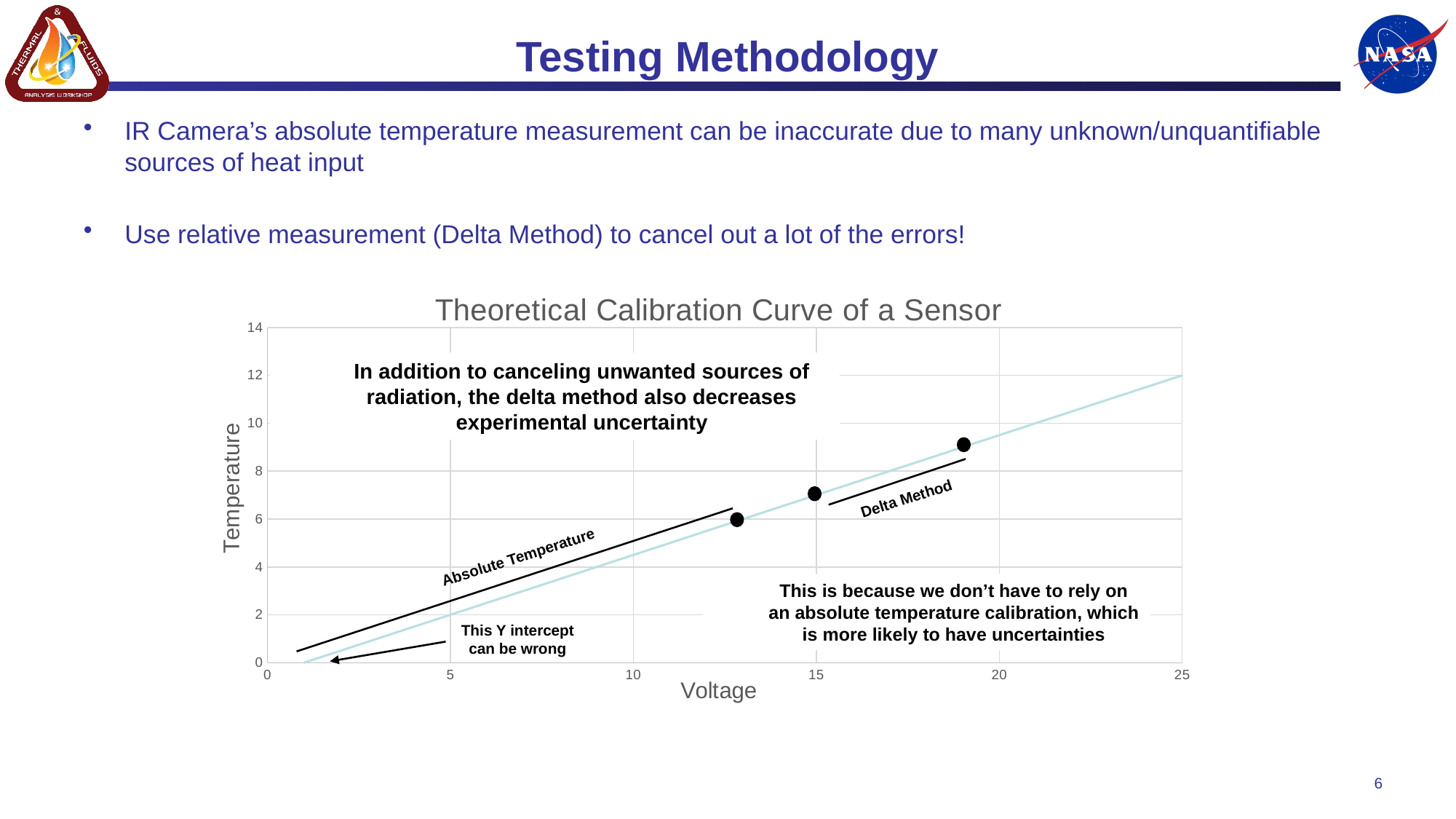
What kind of chart is shown on the slide? line chart Does the temperature rise or fall as voltage increases along the x axis? rise Is the temperature of the rightmost black data point greater or less than 8? greater What is the title of the chart? Theoretical Calibration Curve of a Sensor What is the highest value shown on the Temperature axis? 14 How many black data points are plotted on the chart? 3 Is the temperature of the rightmost black data point greater or less than 10? less Is the temperature of the leftmost black data point greater or less than 8? less What is the label of the x axis of the chart? Voltage Which black data point has the highest temperature: the leftmost or the rightmost? the rightmost